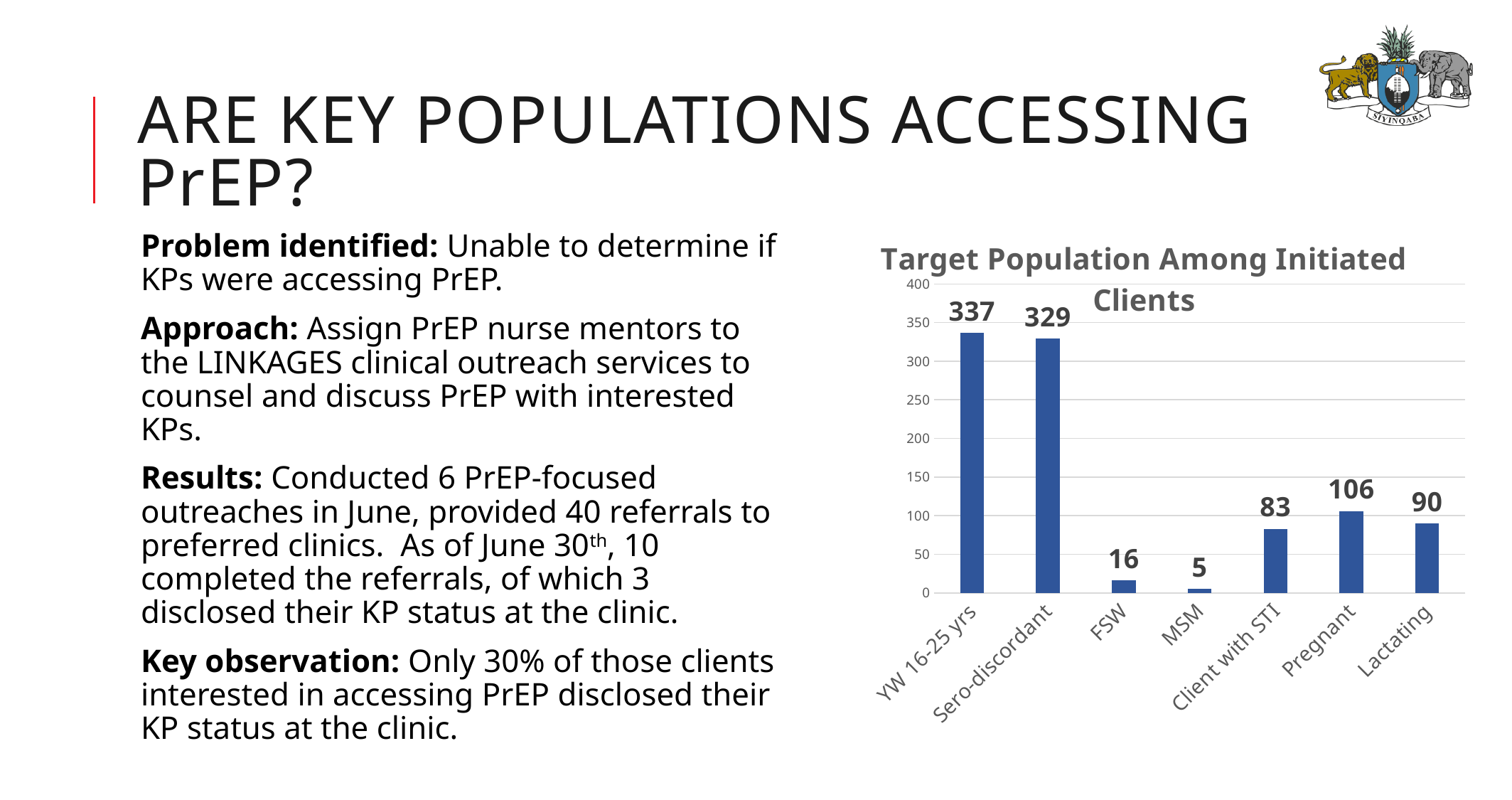
Which is larger, the value for Pregnant or the value for Lactating? Pregnant What is the value for YW 16-25 yrs? 337 Is the value for Client with STI greater or less than 100? less What is the value for Pregnant? 106 What is the value for Client with STI? 83 Which category has the highest value? YW 16-25 yrs How many categories are shown on the x axis? 7 What is the title of the chart? Target Population Among Initiated Clients Which category has the lowest value? MSM What kind of chart is shown on the slide? bar chart What is the difference between the values for FSW and MSM? 11 What is the value for Sero-discordant? 329